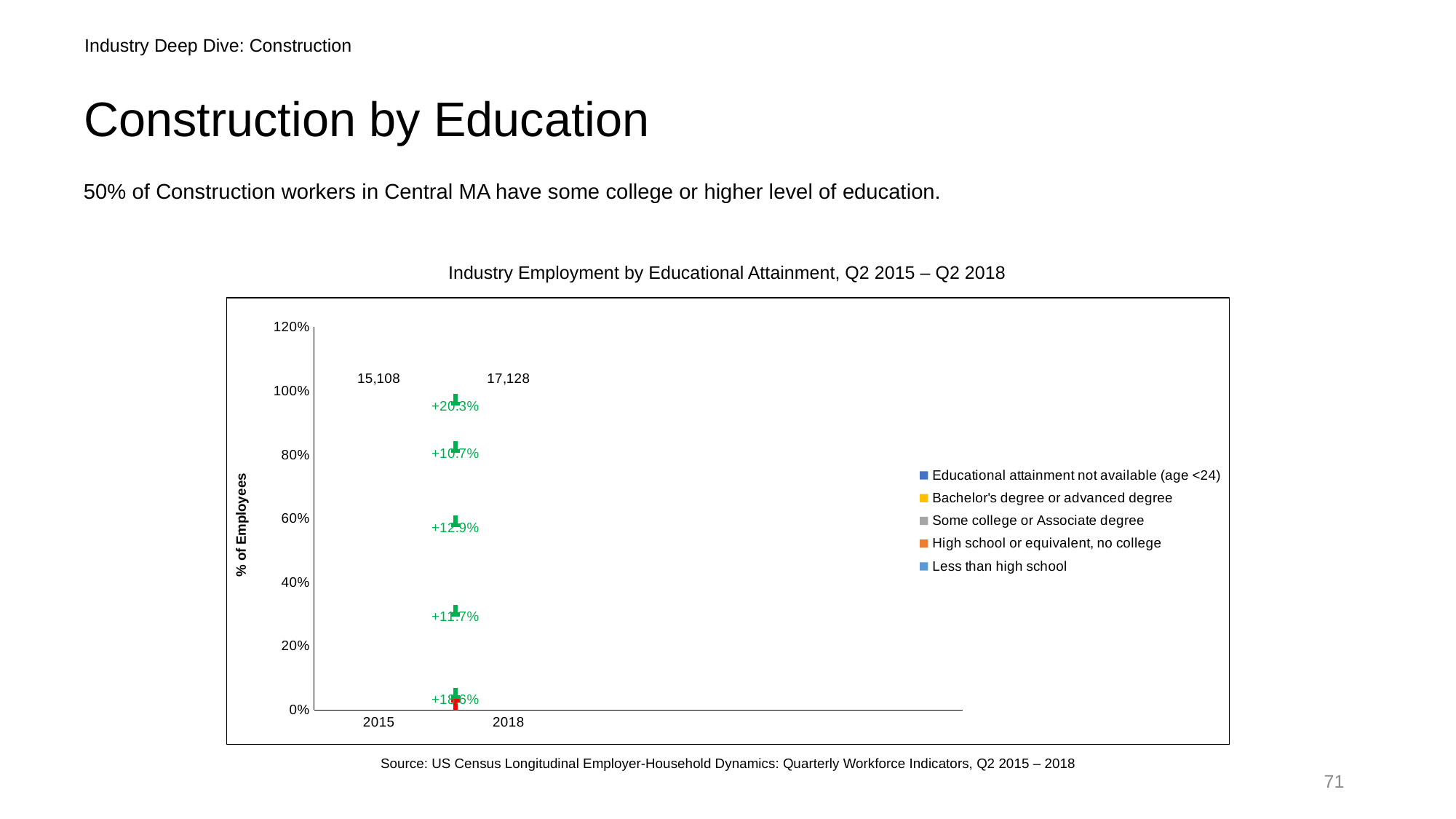
Is the total printed for 2015 greater or less than 16,000? less What is the highest tick value shown on the y axis? 120% What is the title of the chart? Industry Employment by Educational Attainment, Q2 2015 – Q2 2018 What is the smallest percentage change label printed between the two bars? +10.7% How many series does the chart's legend list? 5 How many categories are shown on the x axis of the chart? 2 What total is printed above the 2018 bar? 17,128 What total is printed above the 2015 bar? 15,108 What is the difference between the totals printed for 2018 and 2015? 2,020 What is the label on the chart's y axis? % of Employees Which year has the larger total printed above its bar, 2015 or 2018? 2018 What is the largest percentage change label printed between the two bars? +20.3%